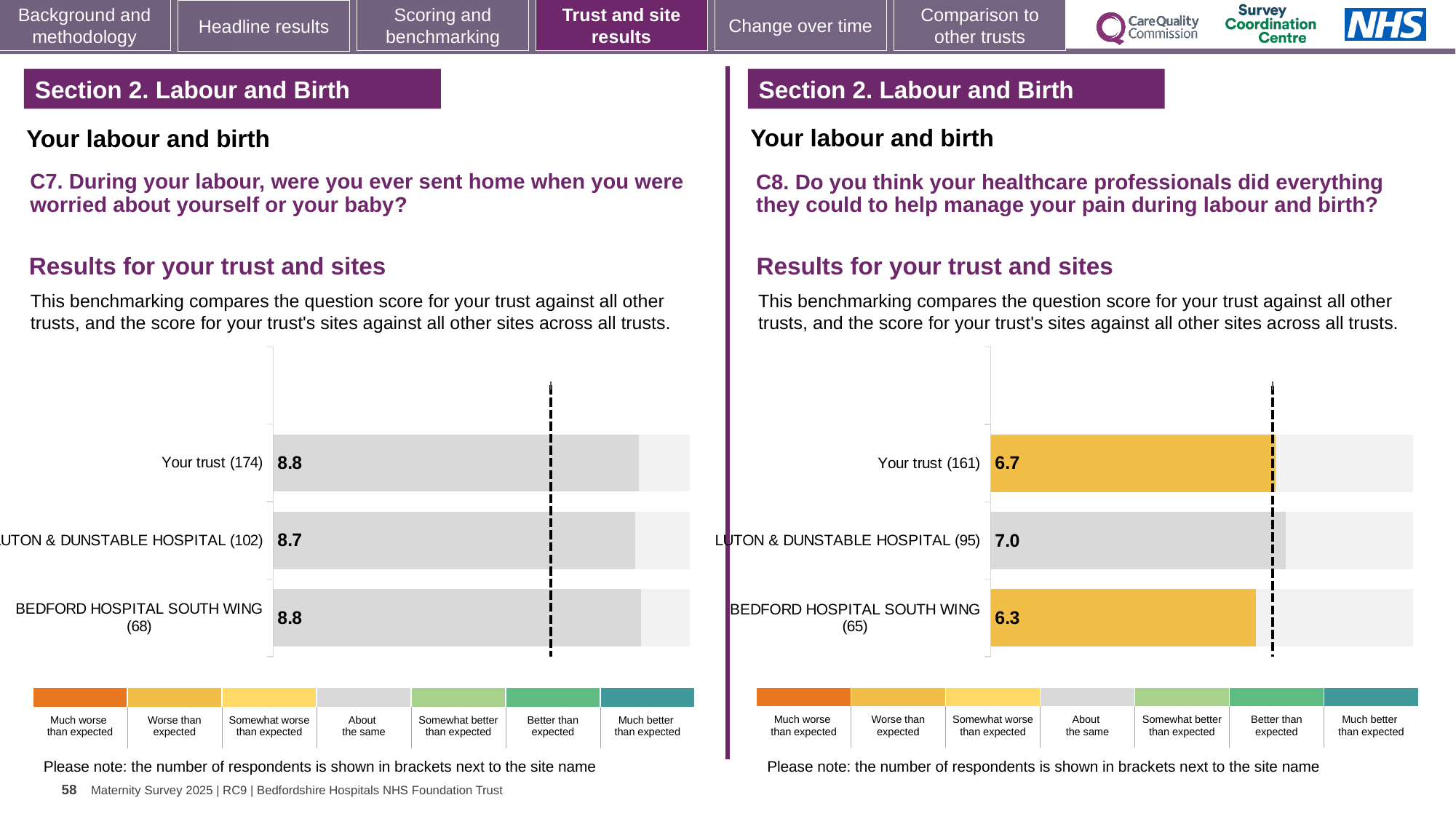
In the left chart (C7), what is the score for Luton & Dunstable Hospital (102)? 8.7 In the left chart (C7), what is the difference between the scores for Your trust (174) and Luton & Dunstable Hospital (102)? 0.1 In the right chart (C8), which has the larger score: Your trust (161) or Bedford Hospital South Wing (65)? Your trust (161) In the right chart (C8), which site or trust has the highest score? Luton & Dunstable Hospital (95) What type of chart is used in the right chart (C8)? Bar chart In the right chart (C8), what is the score for Your trust (161)? 6.7 In the right chart (C8), which site or trust has the lowest score? Bedford Hospital South Wing (65) In the right chart (C8), what is the difference between the scores for Luton & Dunstable Hospital (95) and Bedford Hospital South Wing (65)? 0.7 How many bars are shown in the left chart (C7)? 3 In the left chart (C7), what is the score for Your trust (174)? 8.8 In the right chart (C8), what is the score for Bedford Hospital South Wing (65)? 6.3 In the right chart (C8), what colour is the bar for Bedford Hospital South Wing (65)? Yellow/orange (Worse than expected)